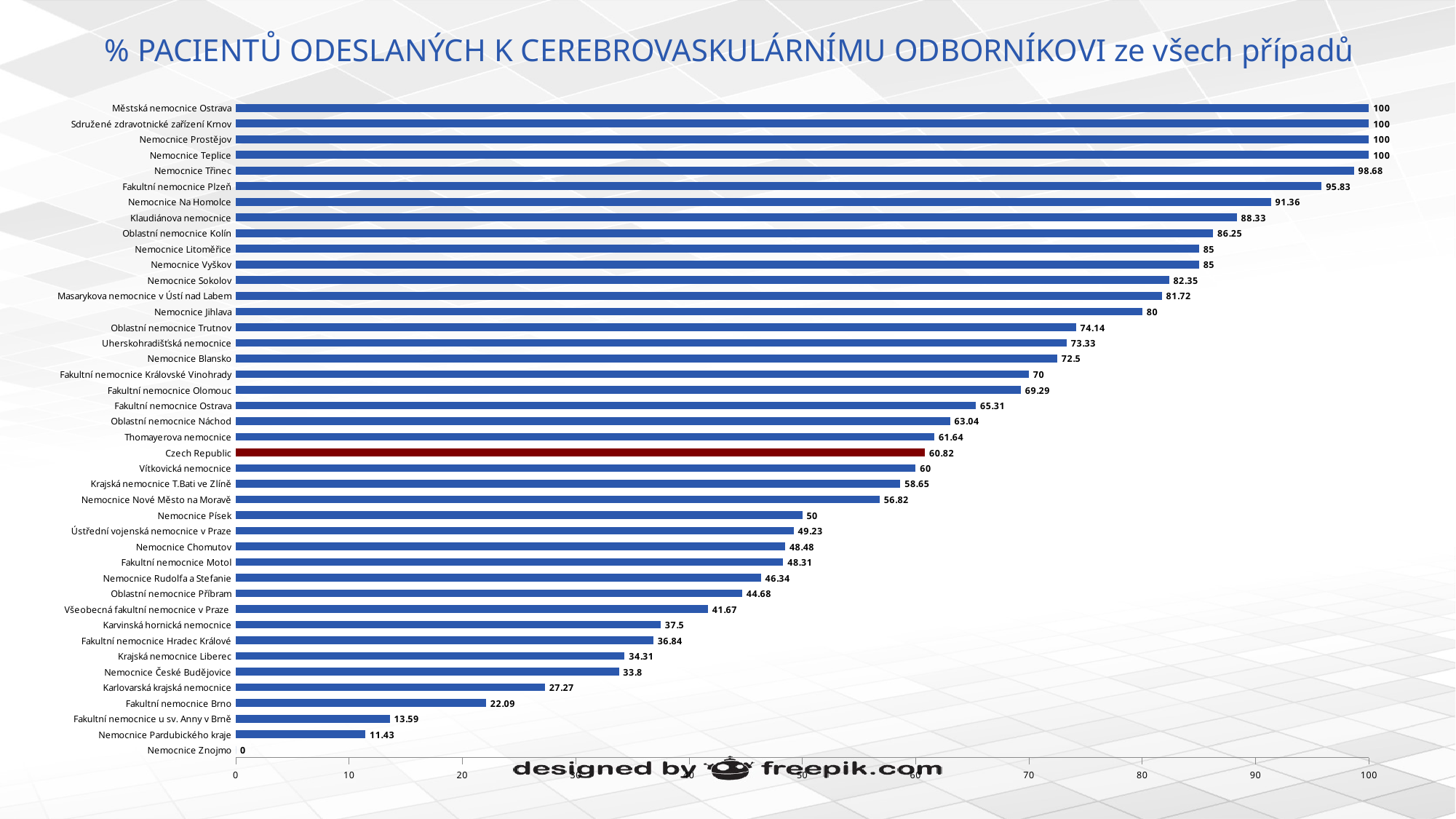
Which has a larger value, Nemocnice Písek or Nemocnice Chomutov? Nemocnice Písek How many hospitals have a value of 100? 4 What kind of chart is shown on the slide? bar chart What is the difference between the values for Fakultní nemocnice Plzeň and Fakultní nemocnice Brno? 73.74 What is the value for Czech Republic? 60.82 What is the value for Fakultní nemocnice Motol? 48.31 How many categories (bars) are plotted in the chart? 42 Which bar is highlighted in a different colour (dark red) from the others? Czech Republic Is the value for Karlovarská krajská nemocnice greater or less than 30? less What is the value for Nemocnice Třinec? 98.68 Which hospital has the lowest value? Nemocnice Znojmo What is the value for Nemocnice Pardubického kraje? 11.43